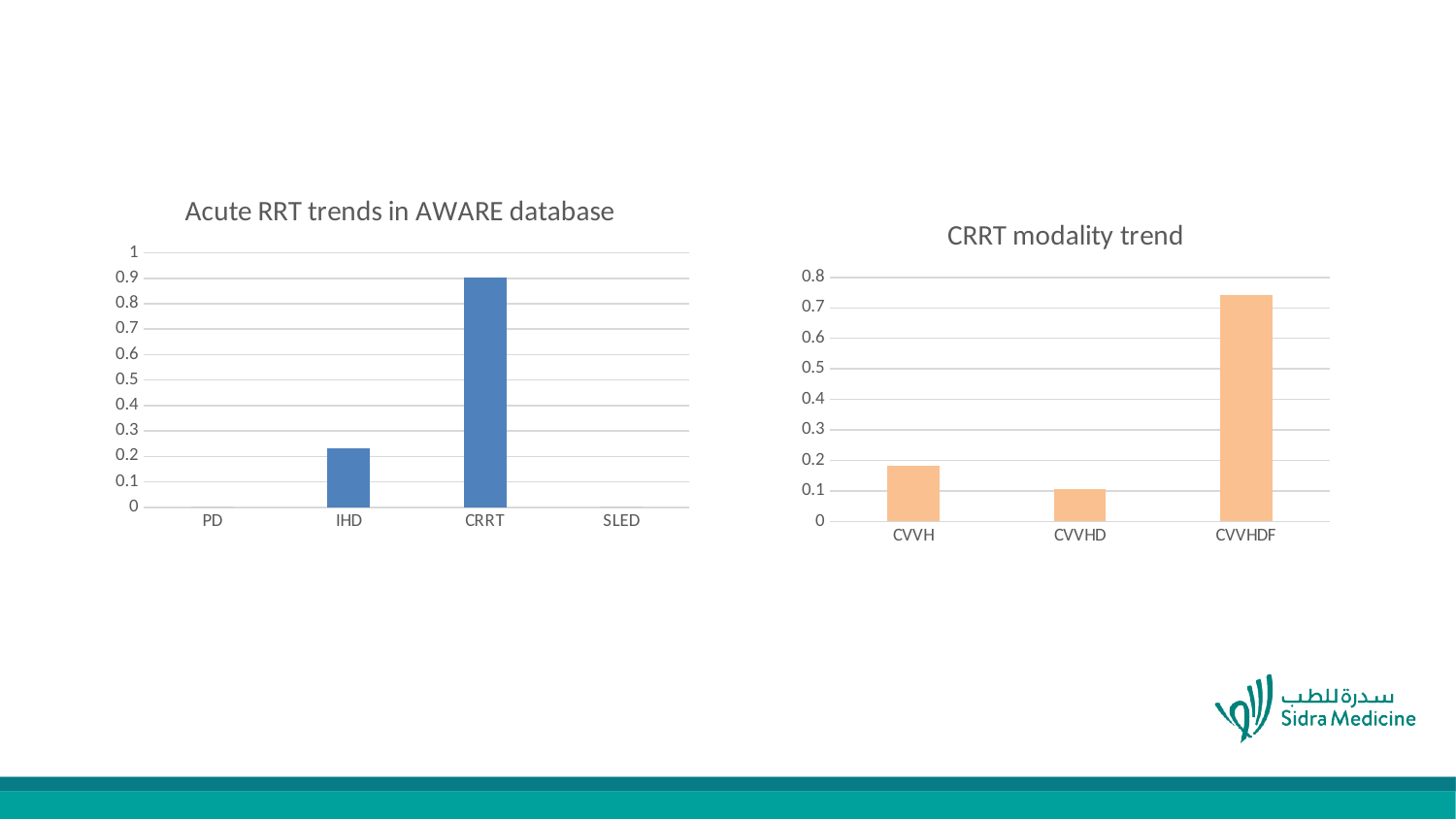
In the chart titled "Acute RRT trends in AWARE database", is the value for CRRT greater or less than 0.8? greater In the chart titled "CRRT modality trend", which is larger, the value for CVVH or the value for CVVHD? CVVH In the chart titled "CRRT modality trend", is the value for CVVH greater or less than 0.3? less In the chart titled "CRRT modality trend", which category has the highest value? CVVHDF In the chart titled "CRRT modality trend", is the value for CVVHDF greater or less than 0.6? greater In the chart titled "Acute RRT trends in AWARE database", which category has the highest value? CRRT How many categories are shown on the x axis of the chart titled "Acute RRT trends in AWARE database"? 4 How many categories are shown on the x axis of the chart titled "CRRT modality trend"? 3 In the chart titled "Acute RRT trends in AWARE database", which is larger, the value for IHD or the value for CRRT? CRRT What type of chart is the chart on the right of the slide? Bar chart In the chart titled "CRRT modality trend", which category has the lowest value? CVVHD